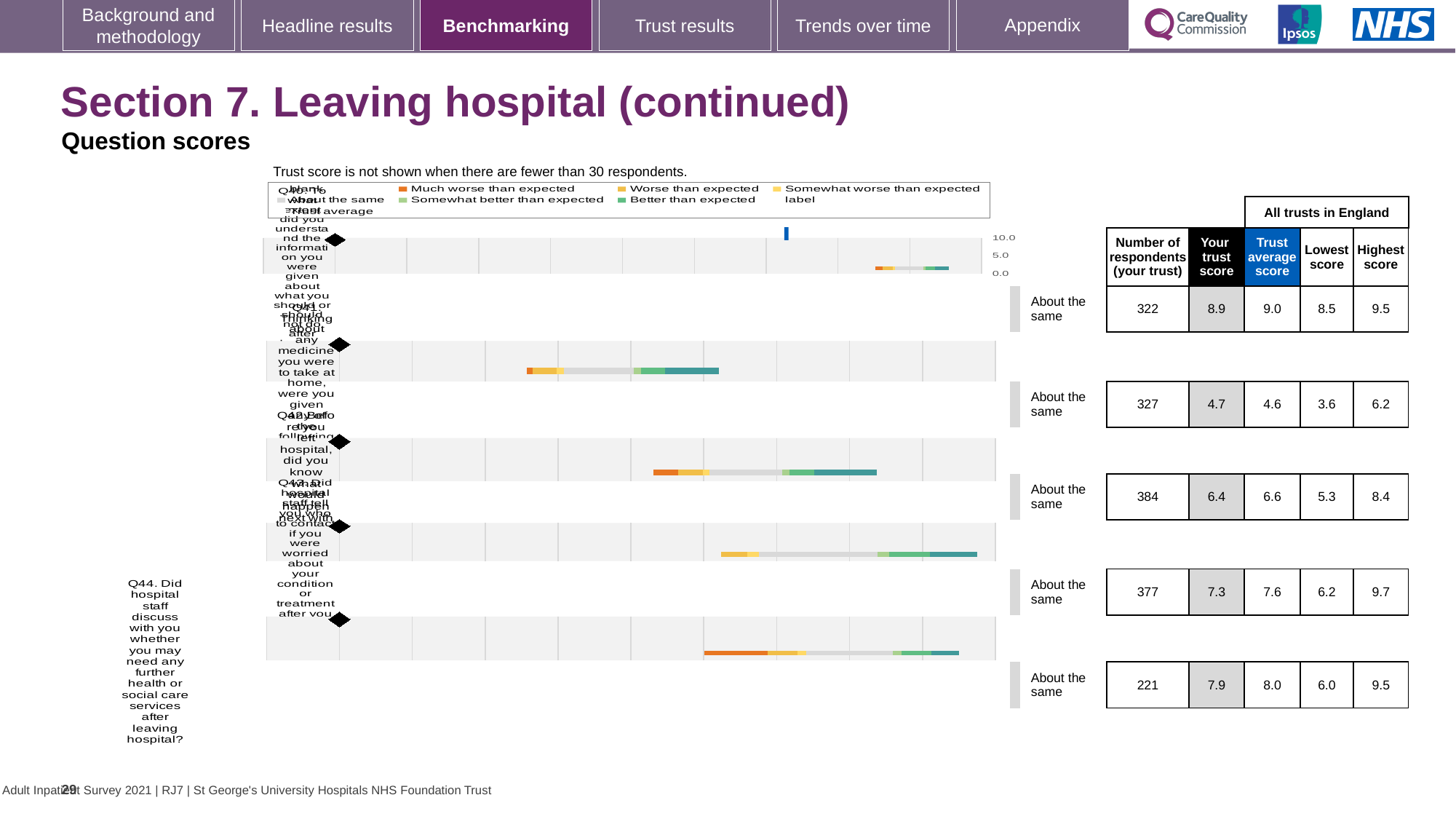
How many questions (rows) are benchmarked on this slide? 5 What is the lowest 'Your trust score' shown in the table on this slide? 4.7 What benchmark category is shown for Q44? About the same What kind of chart is used to show the benchmarking results on this slide? bar chart How many respondents from the trust answered Q44? 221 What is the trust average score for Q44? 8.0 What is the 'Your trust score' for Q44 (whether you may need further health or social care services after leaving hospital)? 7.9 For the question with 384 respondents, what is the lowest score across all trusts in England? 5.3 For Q44, is the trust's own score higher or lower than the trust average score? lower What is the highest 'Your trust score' shown in the table on this slide? 8.9 For Q44, what is the difference between the highest score and the lowest score across all trusts in England? 3.5 What is the highest score across all trusts in England for Q44? 9.5